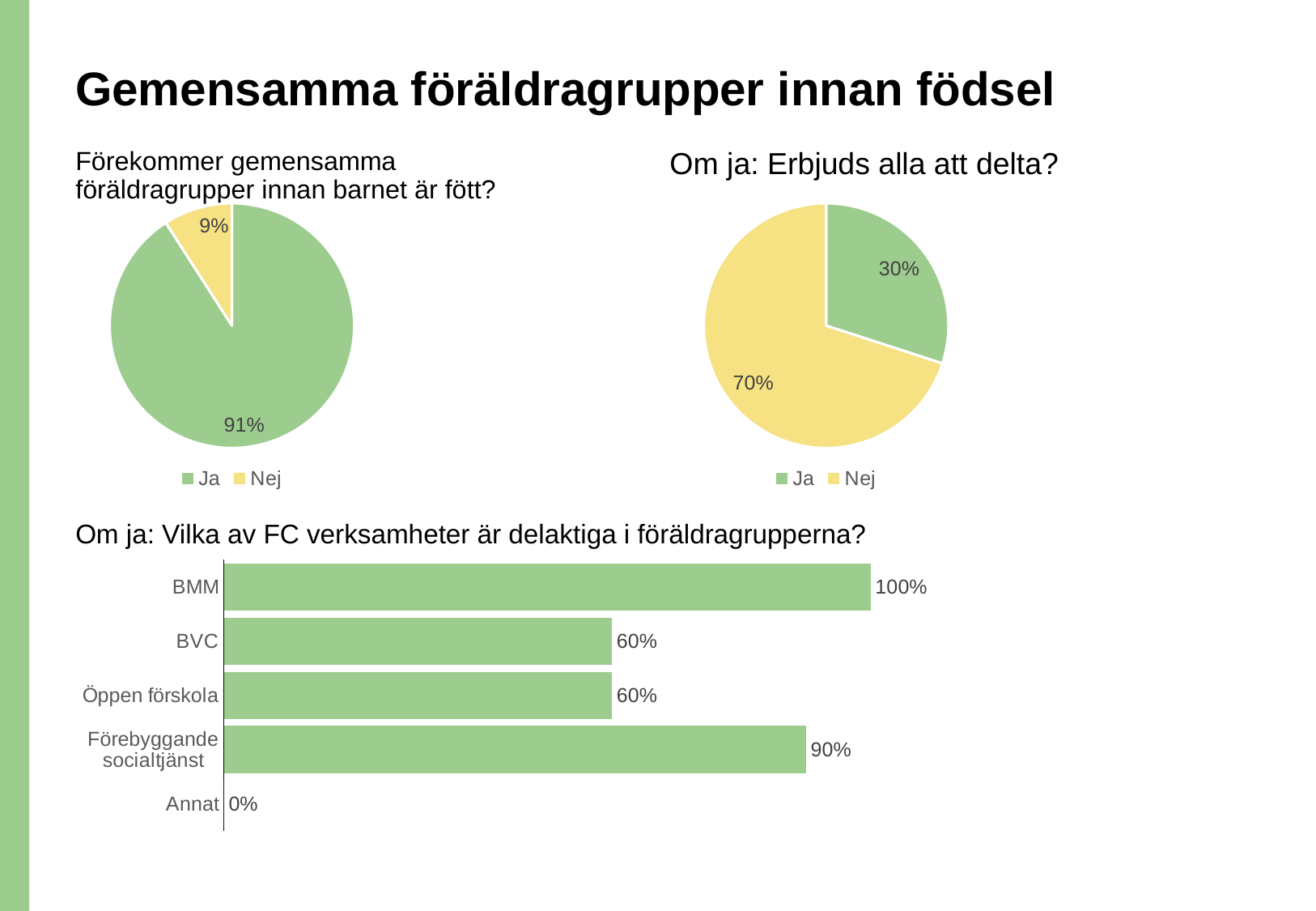
What kind of chart is the chart titled "Om ja: Vilka av FC verksamheter är delaktiga i föräldragrupperna?"? Bar chart In the bar chart titled "Om ja: Vilka av FC verksamheter är delaktiga i föräldragrupperna?", which category has the lowest value? Annat In the bar chart titled "Om ja: Vilka av FC verksamheter är delaktiga i föräldragrupperna?", what is the difference between BMM and BVC? 40% In the bar chart titled "Om ja: Vilka av FC verksamheter är delaktiga i föräldragrupperna?", what is the value for Förebyggande socialtjänst? 90% In the pie chart titled "Om ja: Erbjuds alla att delta?", what is the difference between the Nej and Ja shares? 40% In the pie chart titled "Förekommer gemensamma föräldragrupper innan barnet är fött?", what share is labelled for Ja? 91% How many categories does the bar chart at the bottom of the slide show? 5 In the pie chart titled "Om ja: Erbjuds alla att delta?", which slice is larger, Ja or Nej? Nej In the pie chart titled "Förekommer gemensamma föräldragrupper innan barnet är fött?", what share is labelled for Nej? 9% In the bar chart titled "Om ja: Vilka av FC verksamheter är delaktiga i föräldragrupperna?", which category has the highest value? BMM In the bar chart titled "Om ja: Vilka av FC verksamheter är delaktiga i föräldragrupperna?", what is the value for BMM? 100% In the pie chart titled "Om ja: Erbjuds alla att delta?", what share is labelled for Ja? 30%